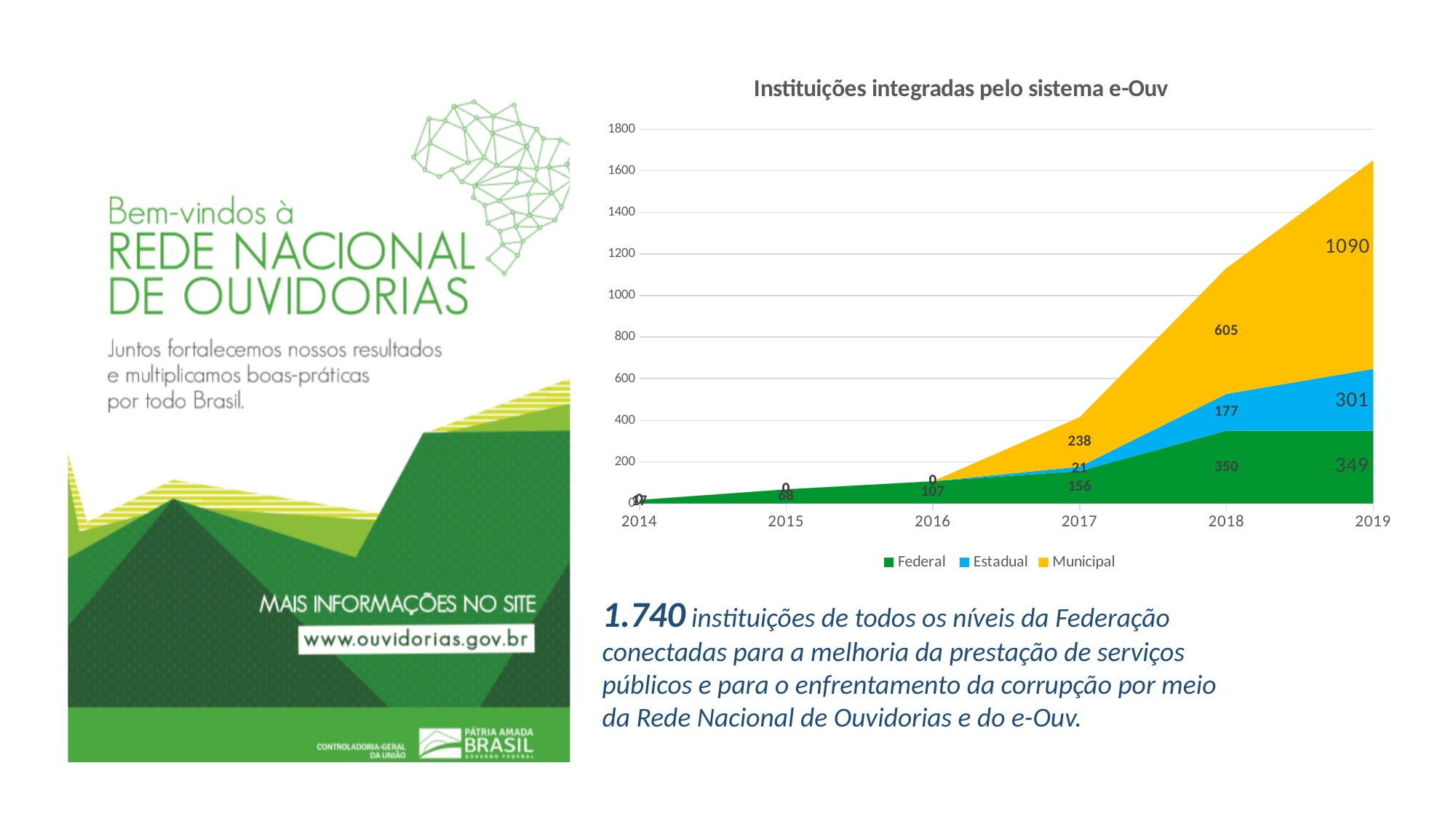
In which year is the Municipal value highest? 2019 What is the value for Estadual in 2017? 21 What is the title of the chart? Instituições integradas pelo sistema e-Ouv How many years are shown on the x axis? 6 What is the total of all three series in 2019? 1740 Which is larger in 2019, Federal or Estadual? Federal What is the value for Federal in 2016? 107 What is the value for Federal in 2018? 350 What is the value for Municipal in 2019? 1090 What kind of chart is shown? Stacked area chart What is the difference between the Municipal values for 2019 and 2018? 485 How many series does the legend list? 3